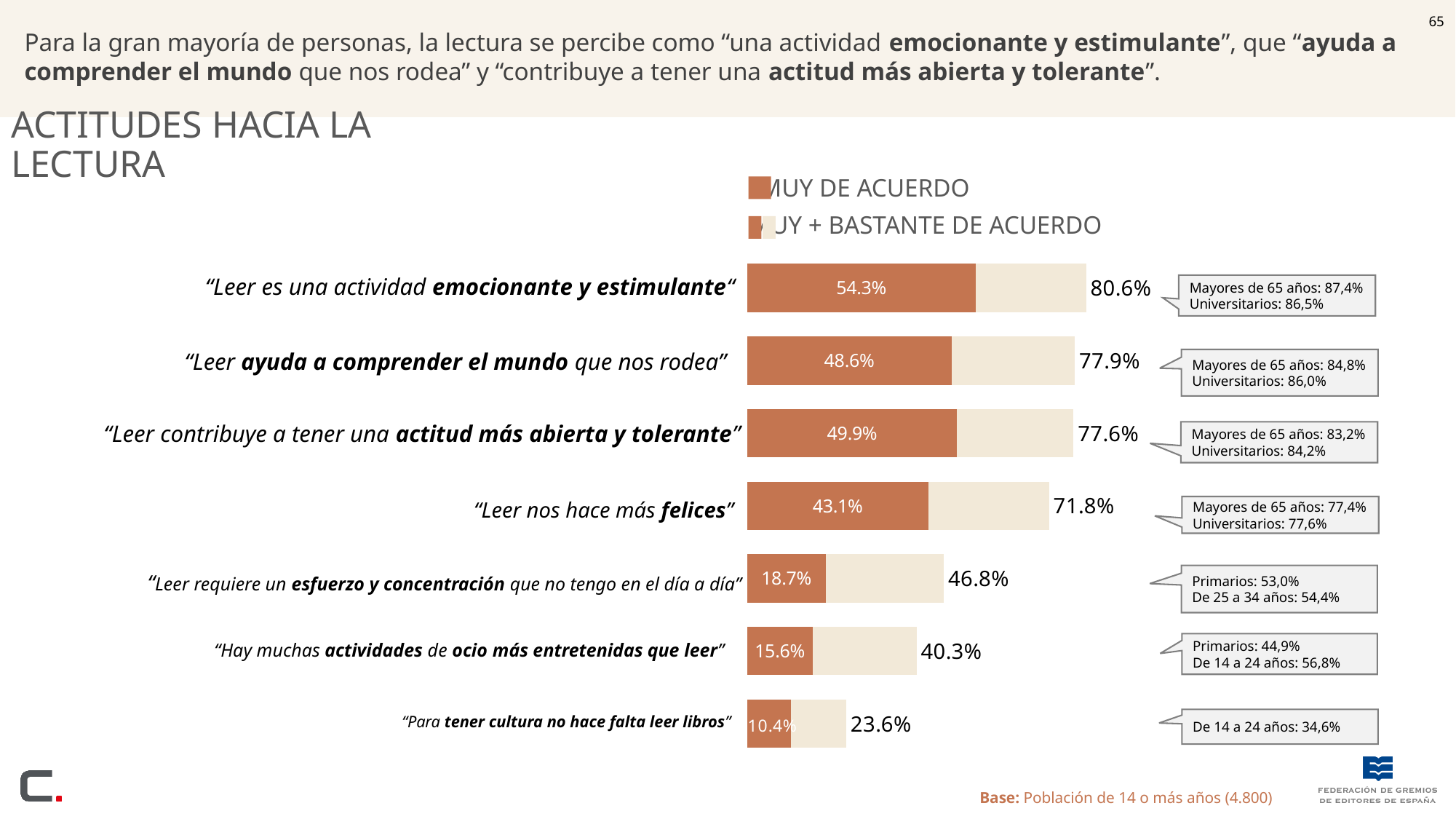
How many series does the legend list? 2 How many statements are shown in the chart? 7 Which statement has the lowest "muy de acuerdo" value? "Para tener cultura no hace falta leer libros" What is the "muy + bastante de acuerdo" value for "Leer nos hace más felices"? 71.8% What is the base population stated below the chart? Población de 14 o más años (4.800) What percentage of respondents are "muy de acuerdo" with "Leer es una actividad emocionante y estimulante"? 54.3% What is the difference between the "muy + bastante de acuerdo" values for "Leer ayuda a comprender el mundo que nos rodea" and "Leer contribuye a tener una actitud más abierta y tolerante"? 0.3% What kind of chart is shown on the slide? Bar chart Which has a higher "muy de acuerdo" value: "Leer ayuda a comprender el mundo que nos rodea" or "Leer contribuye a tener una actitud más abierta y tolerante"? "Leer contribuye a tener una actitud más abierta y tolerante" What is the "muy + bastante de acuerdo" value for "Leer requiere un esfuerzo y concentración que no tengo en el día a día"? 46.8% Which statement has the highest "muy + bastante de acuerdo" value? "Leer es una actividad emocionante y estimulante" What is the "muy de acuerdo" value for "Hay muchas actividades de ocio más entretenidas que leer"? 15.6%